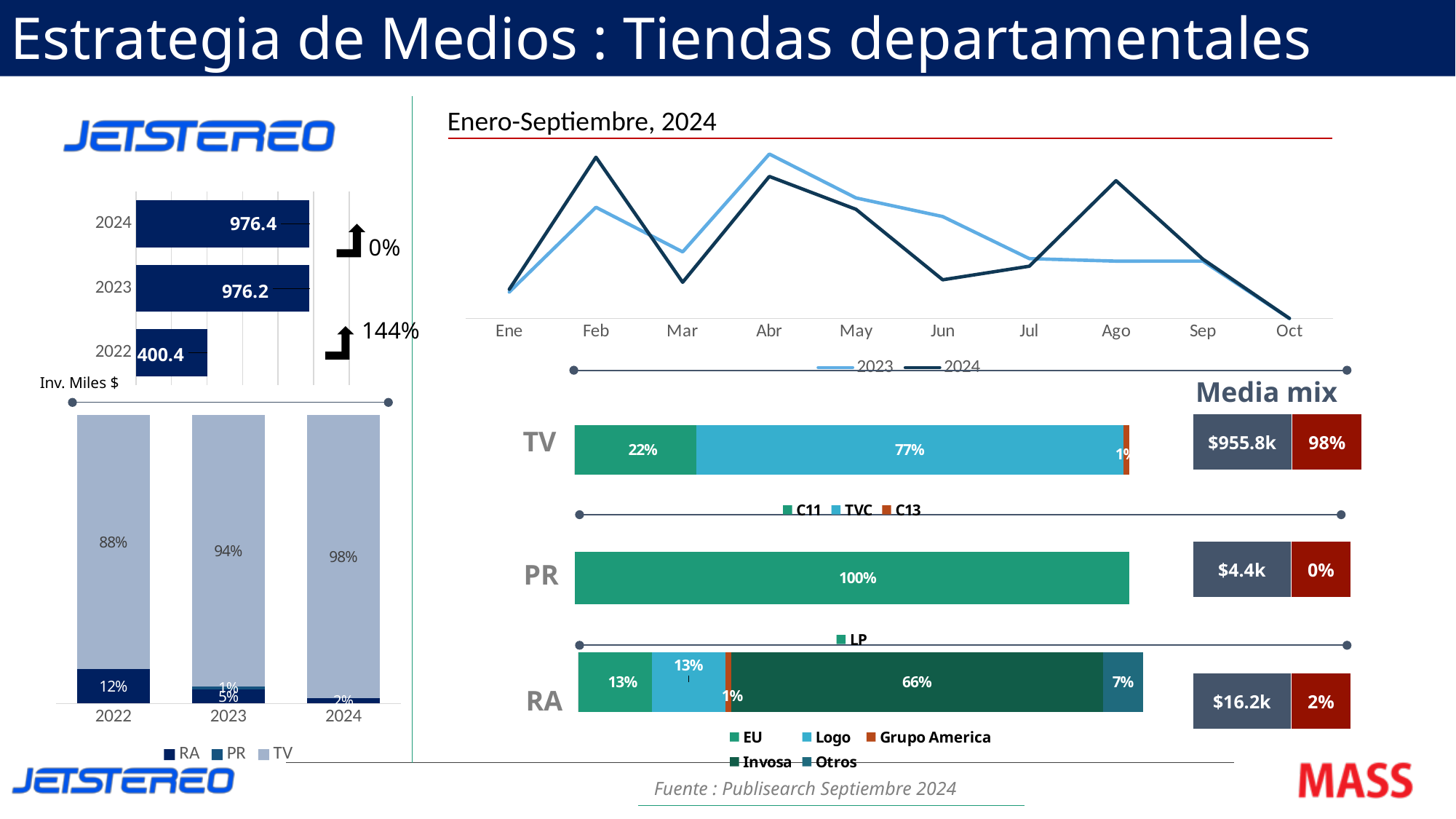
In the TV stacked bar on the right, what is the share for TVC? 77% In the line chart titled 'Enero-Septiembre, 2024', how many months are shown on the x axis? 10 In the horizontal bar chart at the top left (Inv. Miles $), what is the value for 2024? 976.4 In the line chart titled 'Enero-Septiembre, 2024', which two series does the legend list? 2023 and 2024 In the horizontal bar chart at the top left (Inv. Miles $), which year has the lowest value? 2022 In the horizontal bar chart at the top left (Inv. Miles $), what is the value for 2022? 400.4 In the stacked bar chart at the bottom left, what is the TV share for 2023? 94% In the RA stacked bar on the right, which channel has the largest share? Invosa In the stacked bar chart at the bottom left, does the TV share rise or fall from 2022 to 2024? rise In the stacked bar chart at the bottom left, what is the RA share for 2022? 12% In the stacked bar chart at the bottom left, how many series does the legend list? 3 In the horizontal bar chart at the top left (Inv. Miles $), what is the difference between the 2023 value and the 2022 value? 575.8